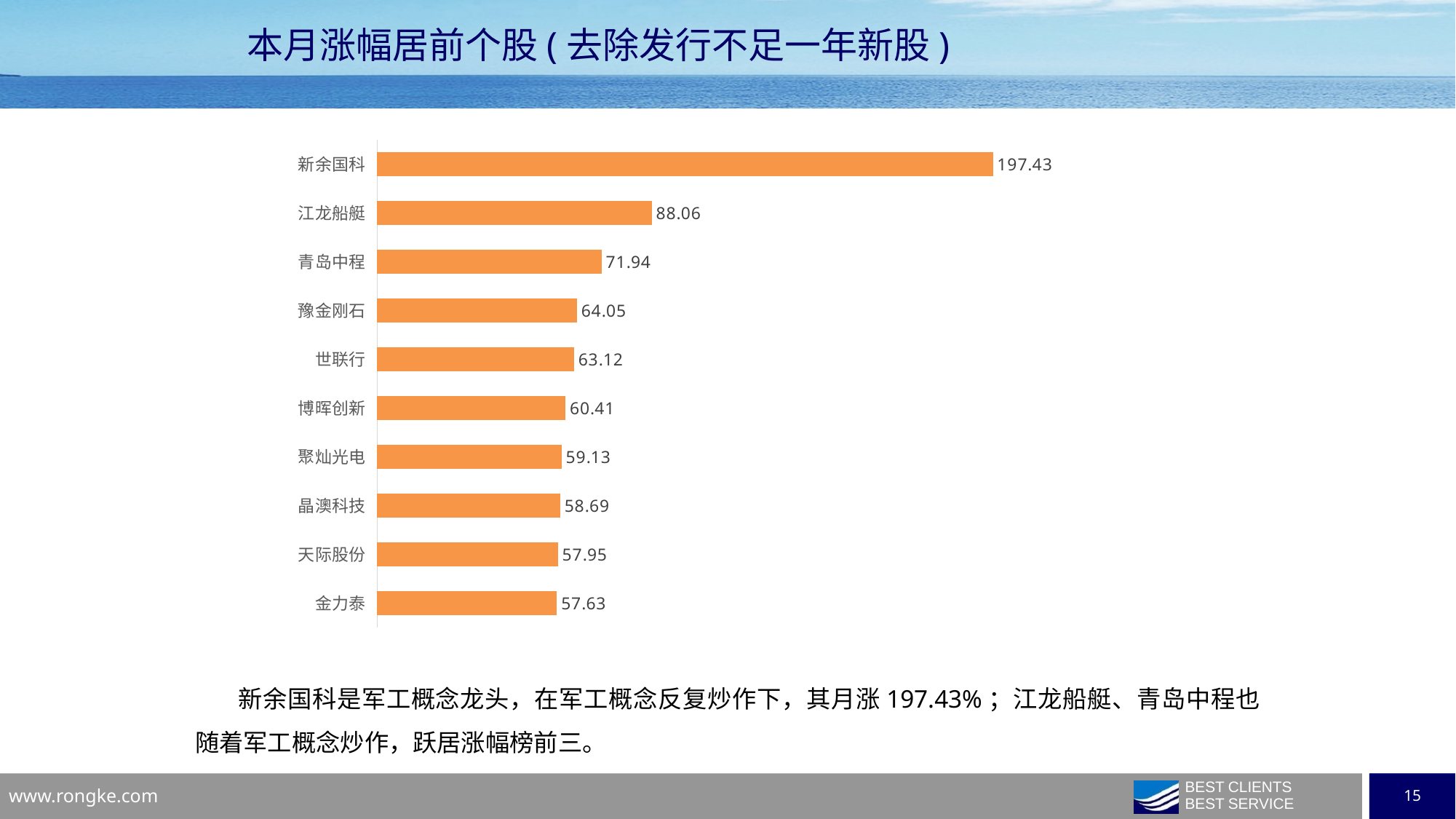
Which stock has the lowest value? 金力泰 What is the value for 新余国科? 197.43 Which has a larger value, 博晖创新 or 晶澳科技? 博晖创新 What is the value for 江龙船艇? 88.06 Which stock has the highest value? 新余国科 What is the value for 世联行? 63.12 What colour are the bars in the chart? Orange What is the value for 金力泰? 57.63 How many stocks are shown in the chart? 10 What is the difference between the values for 新余国科 and 江龙船艇? 109.37 What is the difference between the values for 青岛中程 and 豫金刚石? 7.89 What kind of chart is shown on the slide? Bar chart